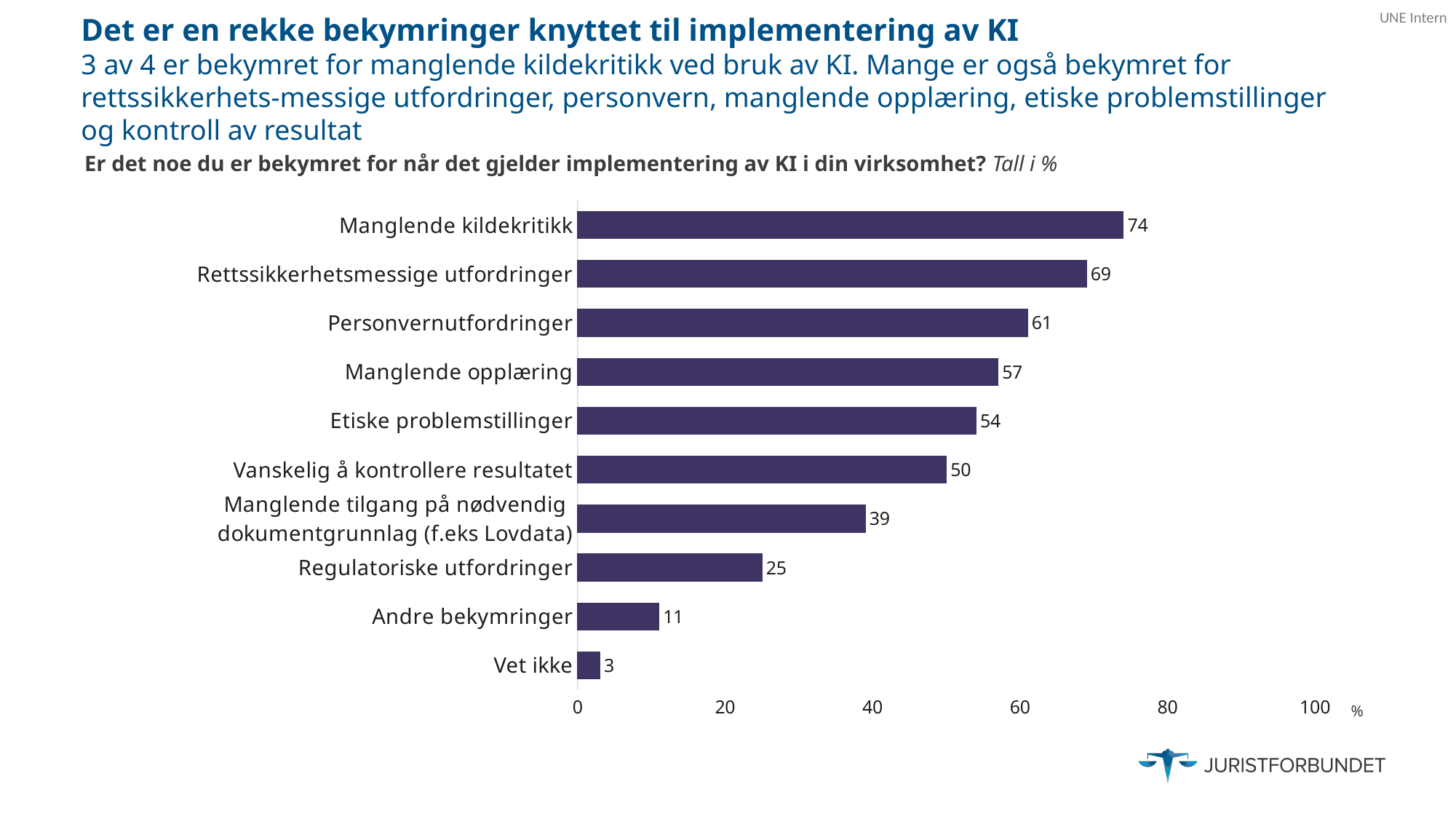
What is the maximum value shown on the horizontal axis? 100 Which is larger, the value for Manglende opplæring or the value for Etiske problemstillinger? Manglende opplæring What kind of chart is shown on the slide? Bar chart What is the difference between the values for Andre bekymringer and Vet ikke? 8 Which category has the lowest value? Vet ikke Is the value for Vanskelig å kontrollere resultatet greater or less than 40? greater What is the value for Manglende kildekritikk? 74 What is the difference between the values for Manglende kildekritikk and Rettssikkerhetsmessige utfordringer? 5 What is the value for Personvernutfordringer? 61 How many categories are shown in the chart? 10 Which category has the highest value? Manglende kildekritikk What is the value for Regulatoriske utfordringer? 25